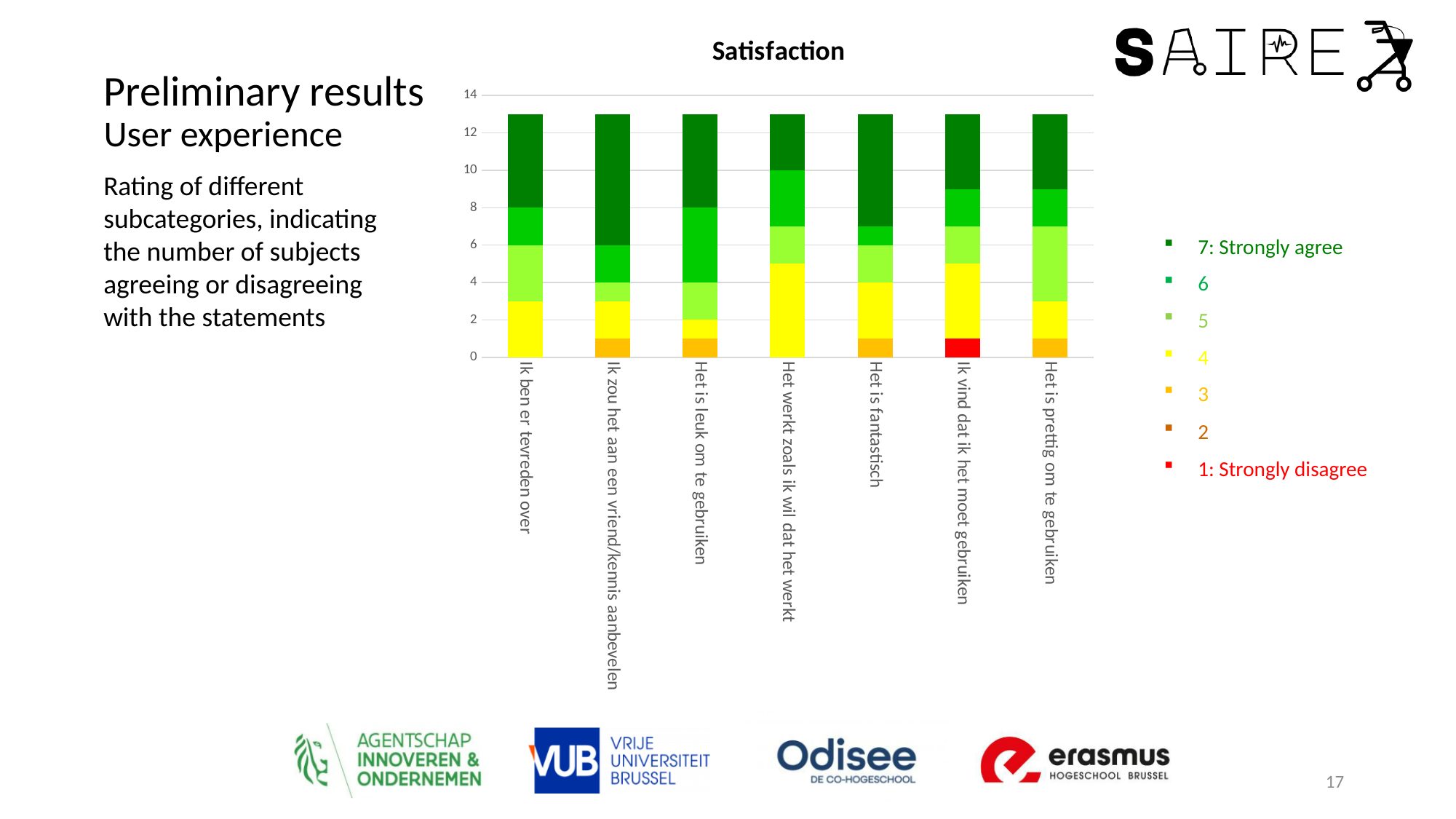
What is the title of the chart? Satisfaction What type of chart is shown on the slide? Stacked bar chart How many series does the chart legend list? 7 Which statement has the smallest dark green (7: Strongly agree) segment? Het werkt zoals ik wil dat het werkt Is the dark green (7: Strongly agree) segment larger for "Het is fantastisch" or for "Het werkt zoals ik wil dat het werkt"? Het is fantastisch How many statements (categories) are shown on the x axis of the chart? 7 Is the total height of the bar for "Ik ben er tevreden over" greater or less than 14? less Which statement is the only one with a red (1: Strongly disagree) segment? Ik vind dat ik het moet gebruiken Is the yellow (4) segment larger for "Het werkt zoals ik wil dat het werkt" or for "Het is leuk om te gebruiken"? Het werkt zoals ik wil dat het werkt Which legend entry is shown in red? 1: Strongly disagree Is the total height of the bar for "Het is fantastisch" greater or less than 12? greater Which statement has the largest yellow (4) segment? Het werkt zoals ik wil dat het werkt